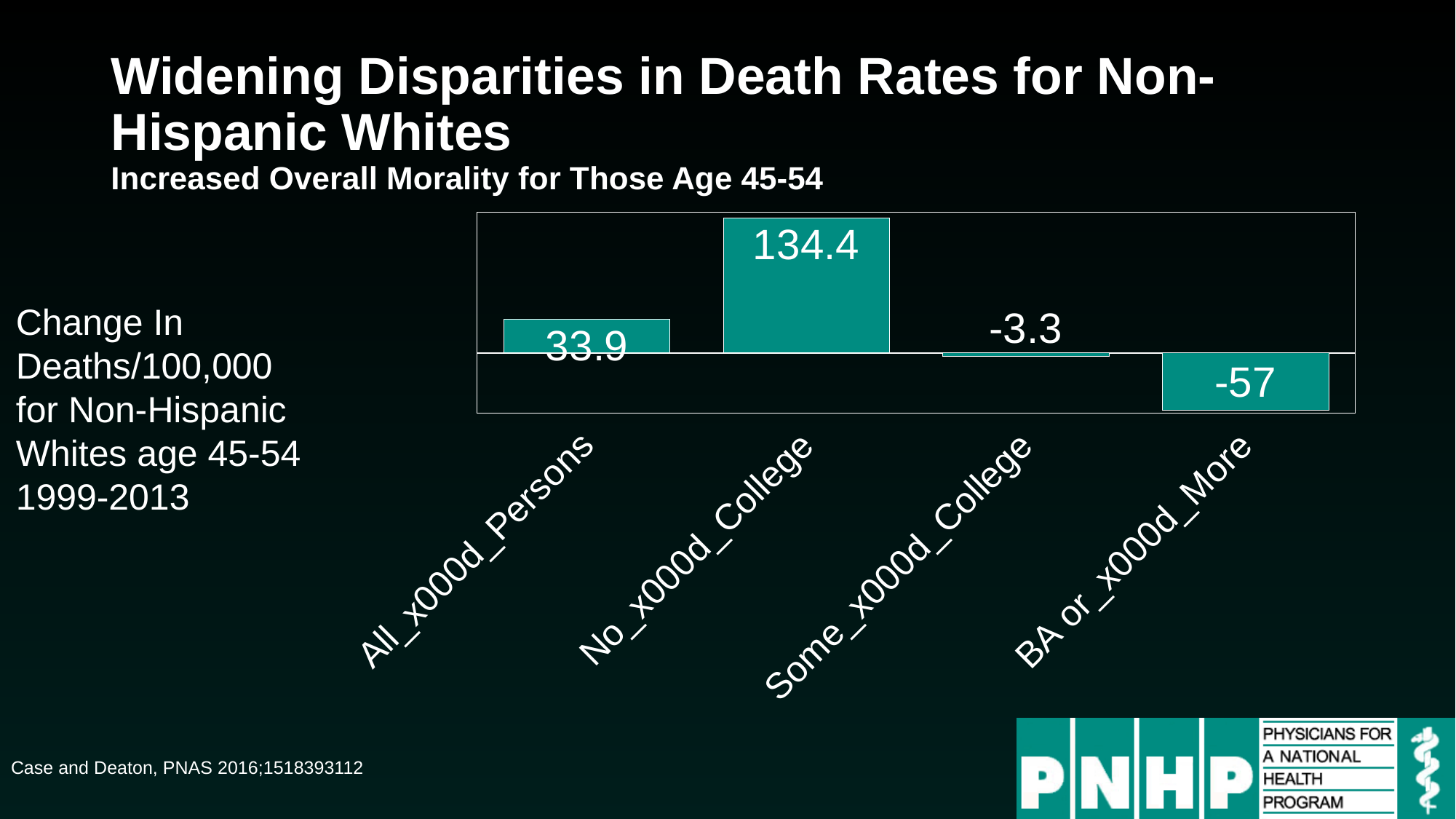
How many categories have negative values? 2 What kind of chart is shown on the slide? Bar chart What is the value for All Persons? 33.9 What is the value for Some College? -3.3 What is the difference between the values for Some College and BA or More? 53.7 What is the value for BA or More? -57 How many categories are shown in the chart? 4 Which category has the highest value? No College Which category has the lowest value? BA or More Which is larger, the value for All Persons or the value for Some College? All Persons What is the value for No College? 134.4 What is the difference between the values for No College and All Persons? 100.5